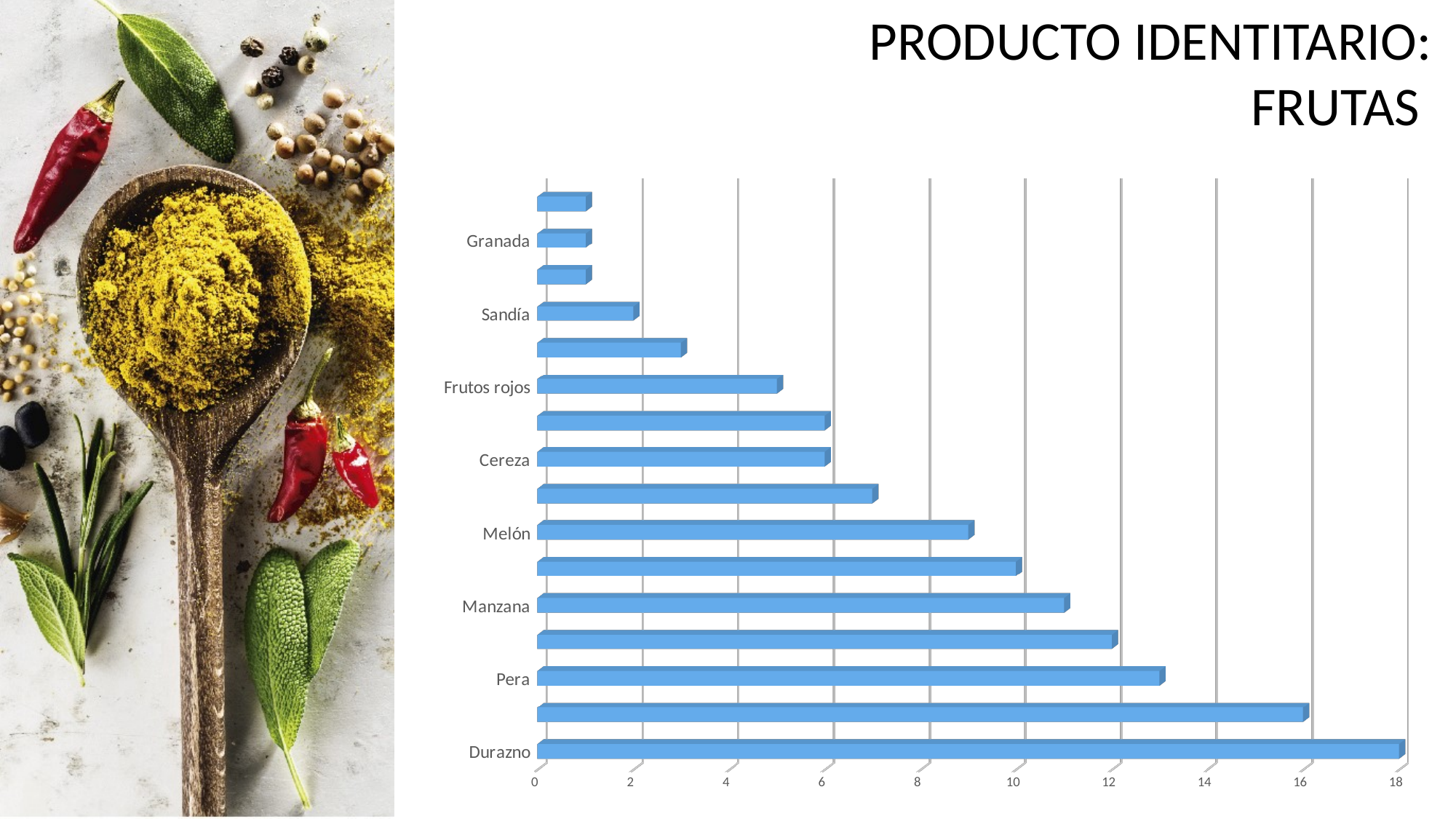
How many bars are plotted in the chart? 16 What is the title of the slide containing the chart? PRODUCTO IDENTITARIO: FRUTAS Which category has the highest value? Durazno What type of chart is shown on the slide? Bar chart What is the value for Sandía? 2 What is the value for Cereza? 6 Is the value for Pera greater or less than 12? greater Which has a larger value, Pera or Manzana? Pera What is the difference between the values for Durazno and Cereza? 12 Is the value for Frutos rojos greater or less than 4? greater Is the value for Melón greater or less than 10? less What is the value for Durazno? 18